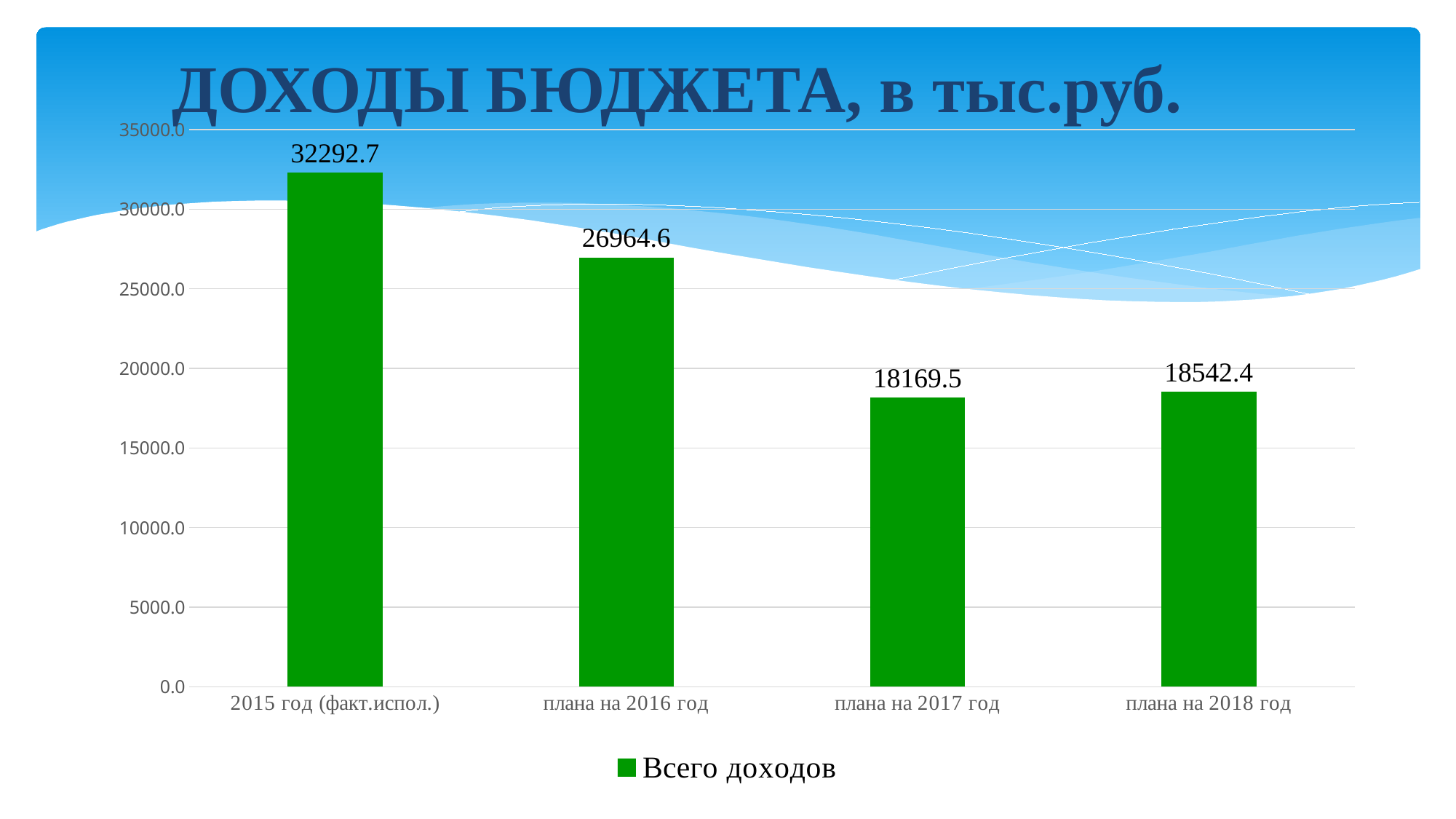
What is the title of the chart? ДОХОДЫ БЮДЖЕТА, в тыс.руб. What is the difference between the values for плана на 2018 год and плана на 2017 год? 372.9 Which category has the lowest value? плана на 2017 год What is the value for плана на 2017 год? 18169.5 Which is larger, the value for плана на 2016 год or плана на 2017 год? плана на 2016 год How many categories are shown on the x axis? 4 What is the value for 2015 год (факт.испол.)? 32292.7 Which category has the highest value? 2015 год (факт.испол.) What is the value for плана на 2018 год? 18542.4 What is the value for плана на 2016 год? 26964.6 What is the difference between the values for 2015 год (факт.испол.) and плана на 2016 год? 5328.1 What kind of chart is shown on the slide? bar chart